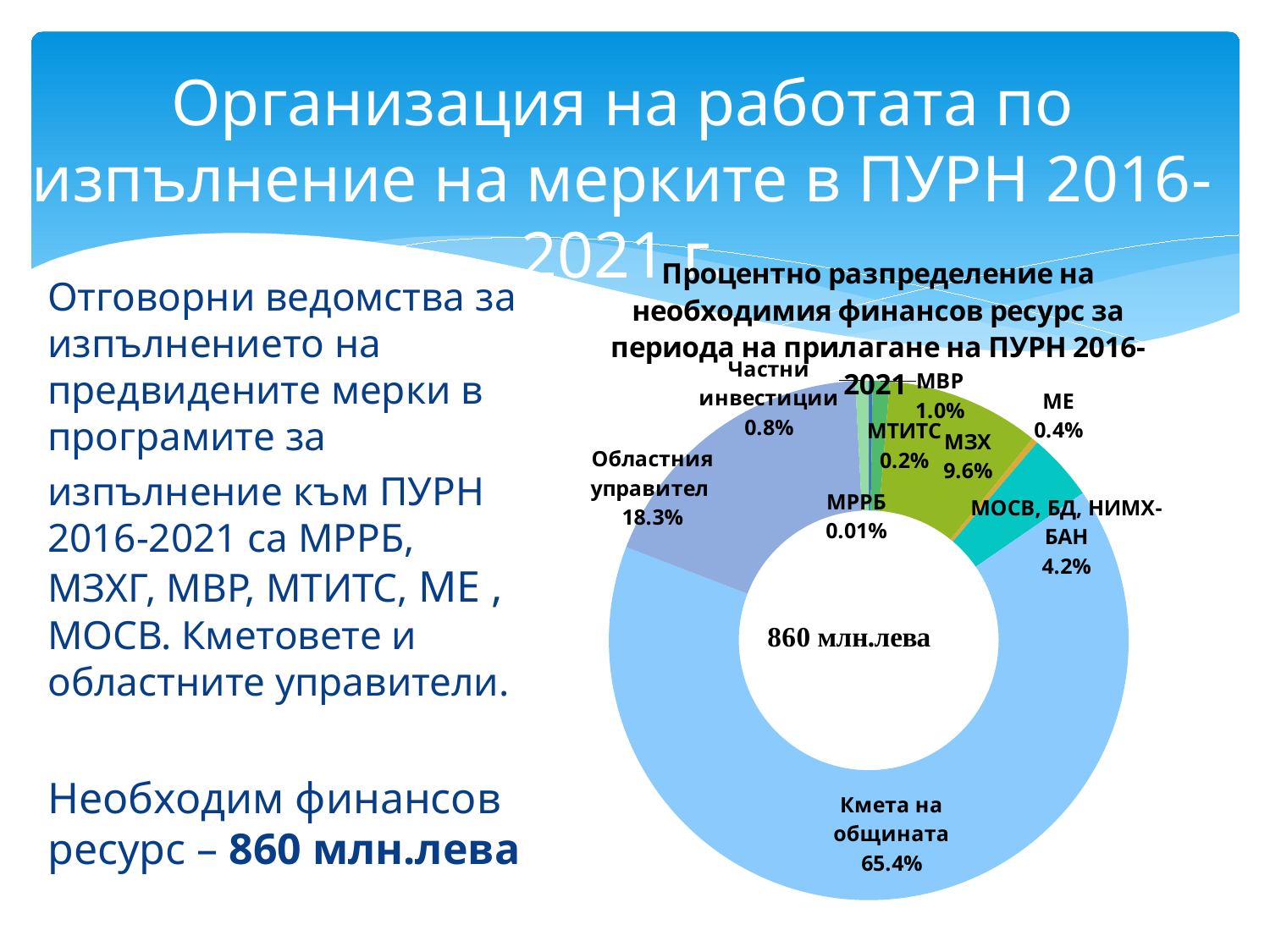
Which category has the smallest share of the chart? МРРБ What share of the chart does "Областния управител" hold? 18.3% What is the value shown for "МЗХ"? 9.6% Which category has the largest share of the chart? Кмета на общината What type of chart is shown on the slide? Doughnut (pie) chart How many categories are shown in the chart? 9 What is the value shown for "МРРБ"? 0.01% What is the difference between the shares of "Кмета на общината" and "Областния управител"? 47.1% What share of the chart does "Кмета на общината" hold? 65.4% Which has a larger share, "МВР" or "Частни инвестиции"? МВР What is the value shown for "МОСВ, БД, НИМХ-БАН"? 4.2% What total amount is written in the centre of the doughnut chart? 860 млн.лева